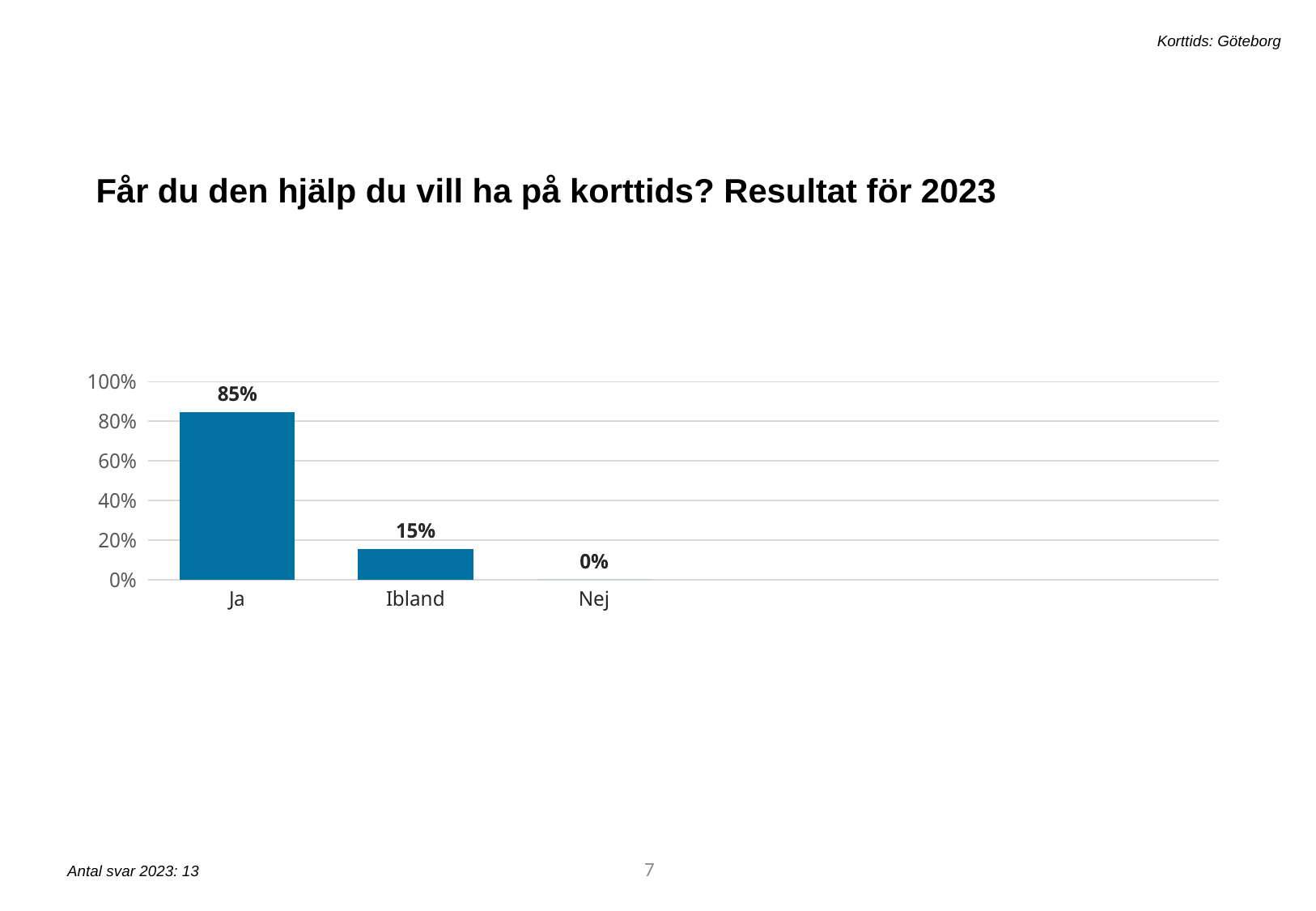
What is the title of the slide above the chart? Får du den hjälp du vill ha på korttids? Resultat för 2023 Is the value for Ja greater or less than 60%? greater Which category has the highest value? Ja What is the difference between the values for Ja and Ibland? 70% What is the value for Ja? 85% What is the value for Nej? 0% Which is larger, the value for Ibland or the value for Nej? Ibland Do the values rise or fall from Ja to Nej along the x axis? fall How many categories are shown on the x axis? 3 Which category has the lowest value? Nej What kind of chart is shown on the slide? bar chart What is the value for Ibland? 15%